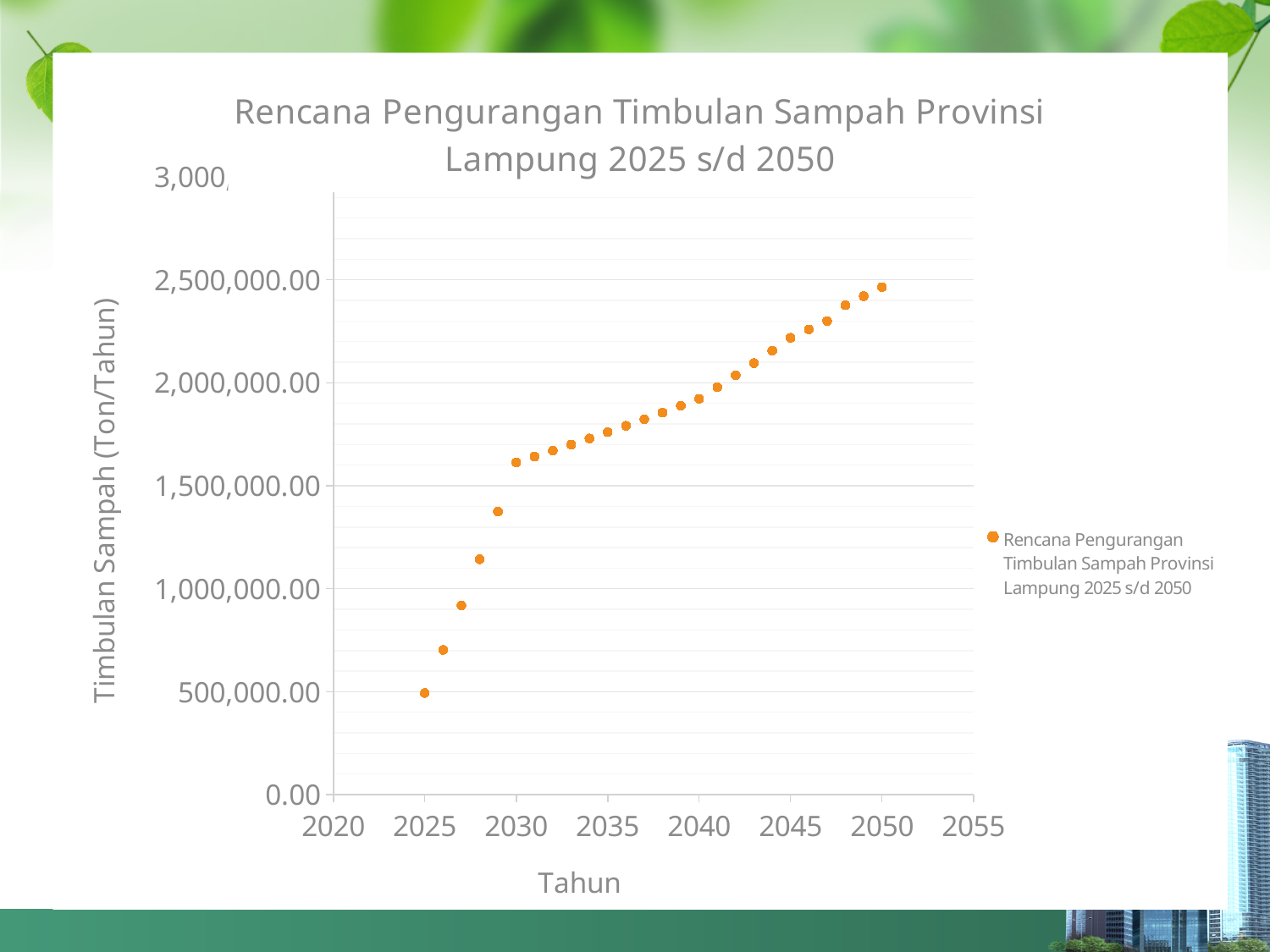
What kind of chart is shown on the slide? Scatter chart Is the value for 2027 greater or less than 1,000,000.00? less Do the plotted values rise or fall as the year increases from 2025 to 2050? Rise How many series does the legend list? 1 Which year has the highest plotted value? 2050 Which year has the larger value, 2035 or 2045? 2045 What is the label of the vertical axis? Timbulan Sampah (Ton/Tahun) Which year has the lowest plotted value? 2025 Is the value for 2030 greater or less than 1,500,000.00? greater Is the value for 2040 greater or less than 2,000,000.00? less What is the title of the chart? Rencana Pengurangan Timbulan Sampah Provinsi Lampung 2025 s/d 2050